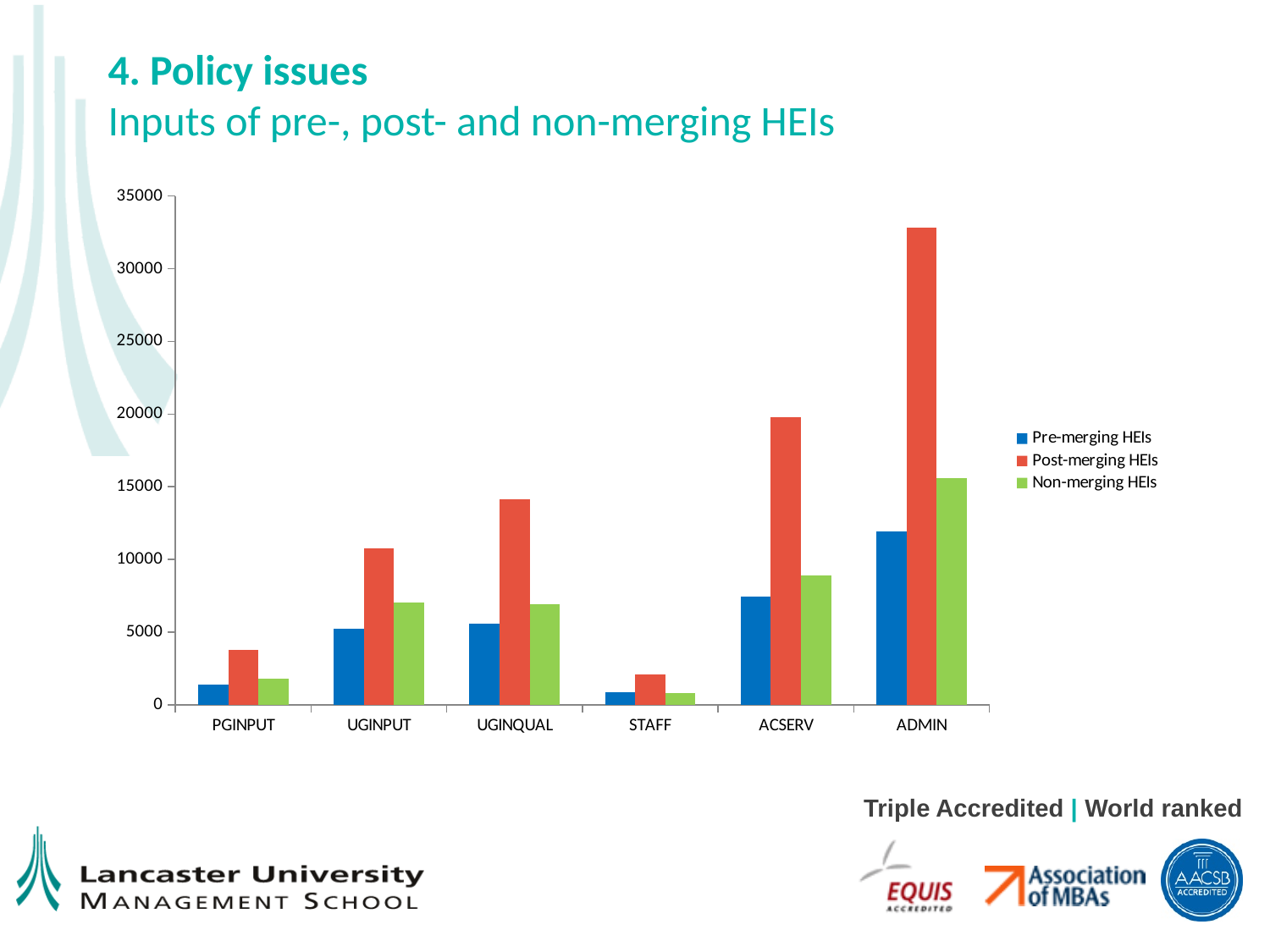
Is the value for Post-merging HEIs in UGINQUAL greater or less than 15000? less What kind of chart is shown on the slide? bar chart How many categories are shown on the x axis of the chart? 6 For ADMIN, which is larger: the value for Pre-merging HEIs or Non-merging HEIs? Non-merging HEIs Is the value for Post-merging HEIs in ADMIN greater or less than 30000? greater Is the value for Post-merging HEIs in ACSERV greater or less than 15000? greater How many series does the legend list? 3 Which category has the lowest value for Post-merging HEIs? STAFF Which series is shown in red in the chart? Post-merging HEIs Which category has the highest value for Post-merging HEIs? ADMIN Which category has the lowest value for Non-merging HEIs? STAFF